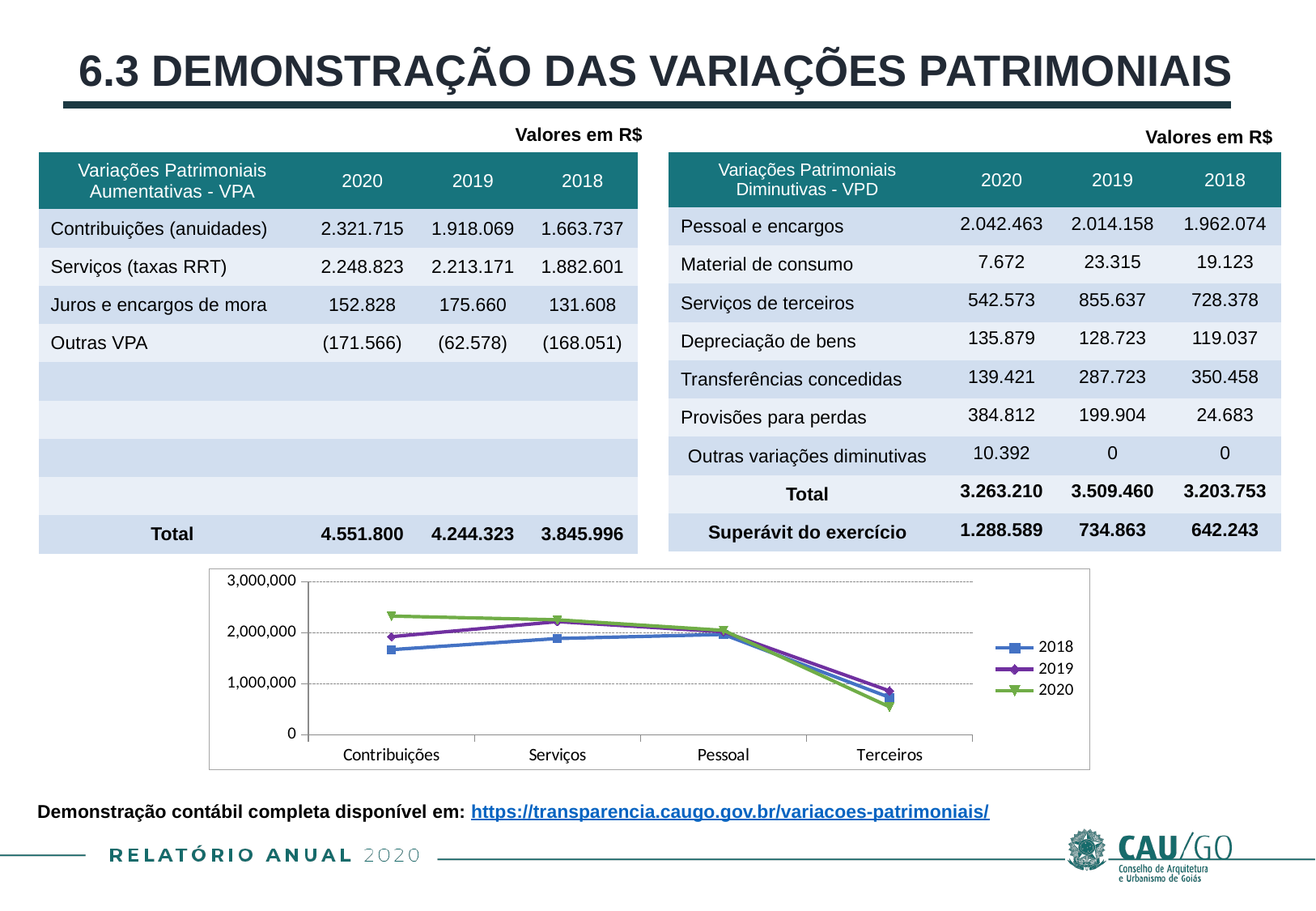
Does the 2020 series rise or fall from Contribuições to Terceiros? fall Which category has the highest value for the 2020 series? Contribuições How many categories are shown on the x axis of the chart? 4 Which category has the lowest value for the 2020 series? Terceiros What kind of chart is shown on the slide? line chart At Contribuições, which series has the larger value, 2020 or 2018? 2020 Which series is drawn in green in the chart? 2020 Is the 2020 value for Contribuições greater or less than 2,000,000? greater Is the 2018 value for Contribuições greater or less than 2,000,000? less Is the 2020 value for Terceiros greater or less than 1,000,000? less How many series does the chart legend list? 3 Which category has the lowest value for the 2018 series? Terceiros